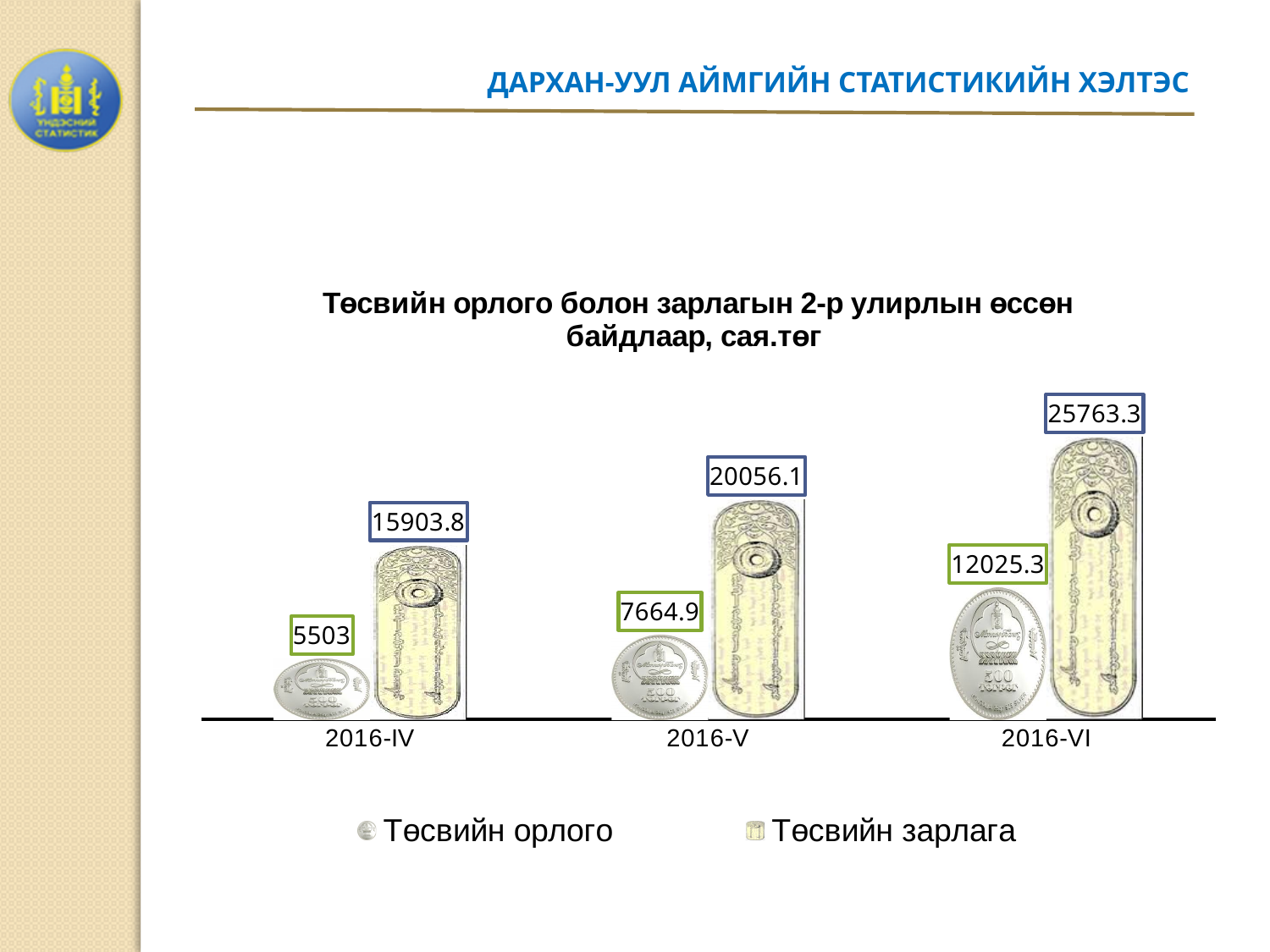
How many series does the legend list? 2 Does Төсвийн зарлага rise or fall from 2016-IV to 2016-VI? rise What is the value of Төсвийн зарлага for 2016-IV? 15903.8 By how much did Төсвийн орлого increase from 2016-IV to 2016-VI? 6522.3 What is the difference between Төсвийн зарлага and Төсвийн орлого in 2016-VI? 13738 What is the value of Төсвийн зарлага for 2016-V? 20056.1 How many periods are shown on the x axis? 3 What is the value of Төсвийн орлого for 2016-IV? 5503 What is the value of Төсвийн орлого for 2016-VI? 12025.3 In which period is Төсвийн орлого lowest? 2016-IV Which is larger in 2016-V, Төсвийн орлого or Төсвийн зарлага? Төсвийн зарлага In which period is Төсвийн зарлага highest? 2016-VI